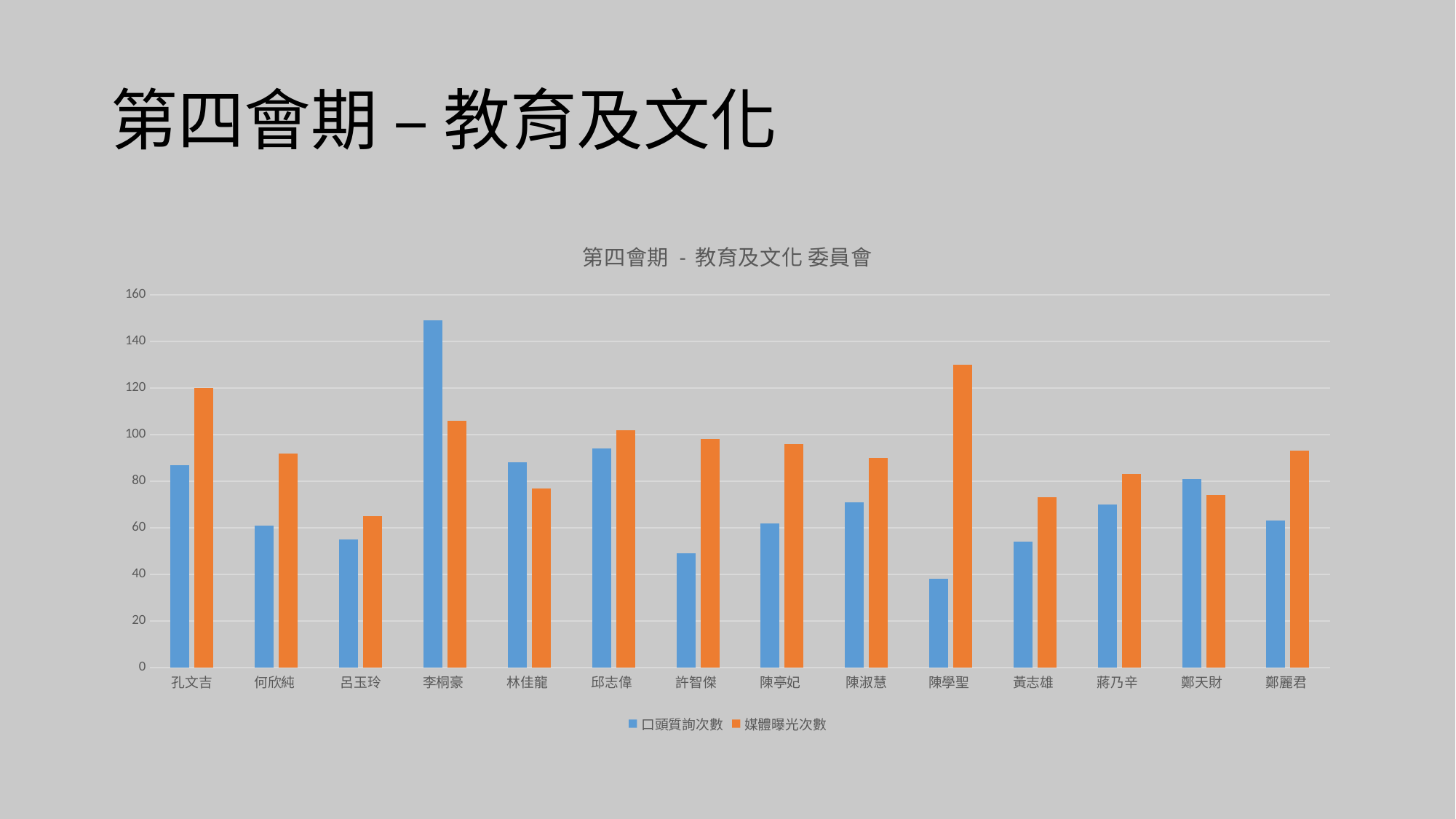
Is the 口頭質詢次數 value for 許智傑 greater or less than 60? less Is the 媒體曝光次數 value for 陳學聖 greater or less than 120? greater Which legislator has the lowest 媒體曝光次數 (orange bar)? 呂玉玲 How many legislators (categories) are shown on the x axis of the chart? 14 What kind of chart is shown on the slide? bar chart How many series does the chart's legend list? 2 Is the 口頭質詢次數 value for 李桐豪 greater or less than 140? greater Which legislator has the highest 媒體曝光次數 (orange bar)? 陳學聖 What is the title of the chart? 第四會期 - 教育及文化 委員會 Which legislator has the highest 口頭質詢次數 (blue bar)? 李桐豪 For 鄭天財, which is larger: 口頭質詢次數 or 媒體曝光次數? 口頭質詢次數 Which legislator has the lowest 口頭質詢次數 (blue bar)? 陳學聖